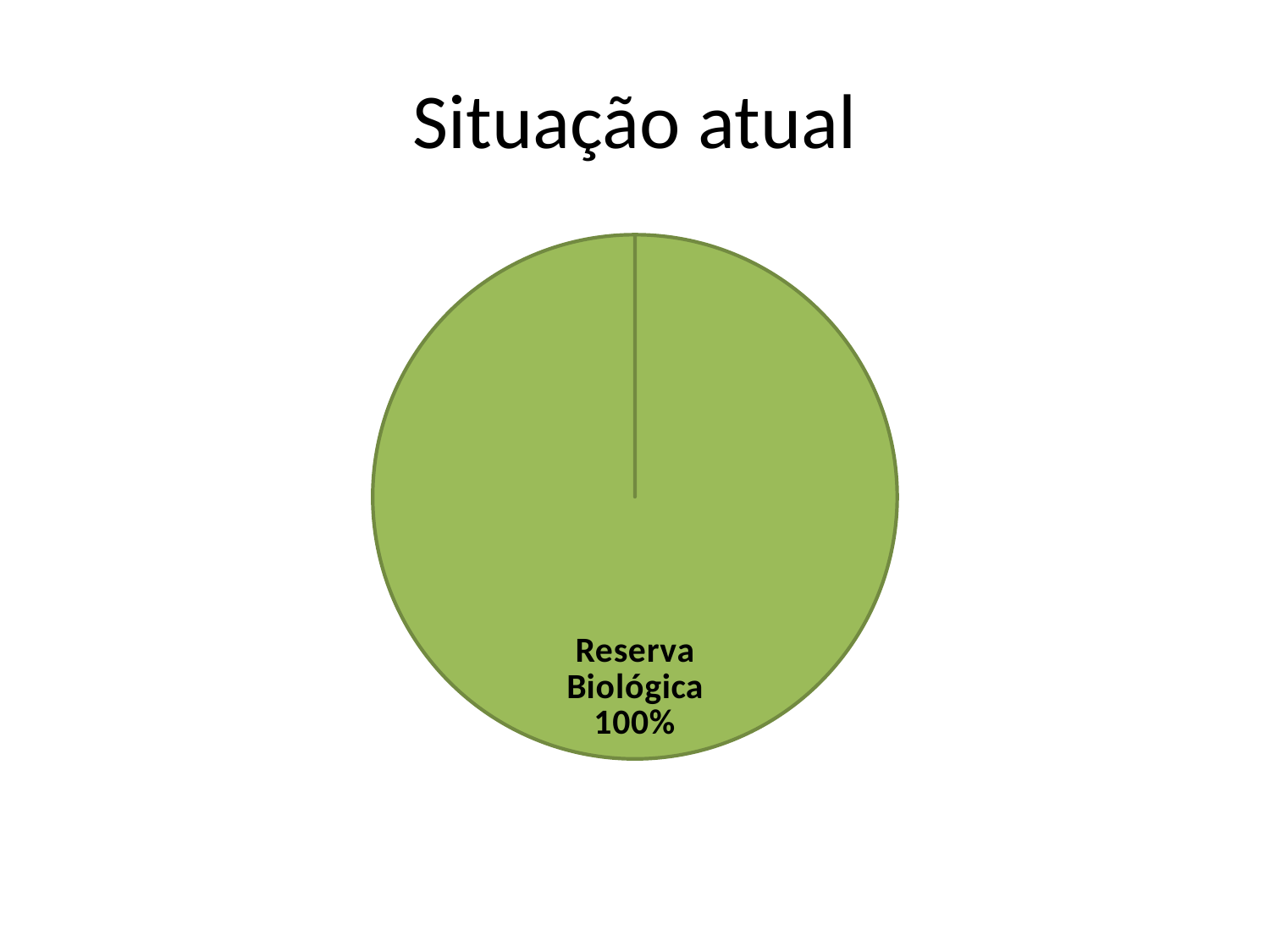
How many slices does the pie chart have? 1 What share of the pie does Reserva Biológica represent? 100% What is the title of the slide? Situação atual What kind of chart is shown on the slide? pie chart What is the label of the only slice in the pie chart? Reserva Biológica What colour is the Reserva Biológica slice? green Which category has the largest share of the pie? Reserva Biológica